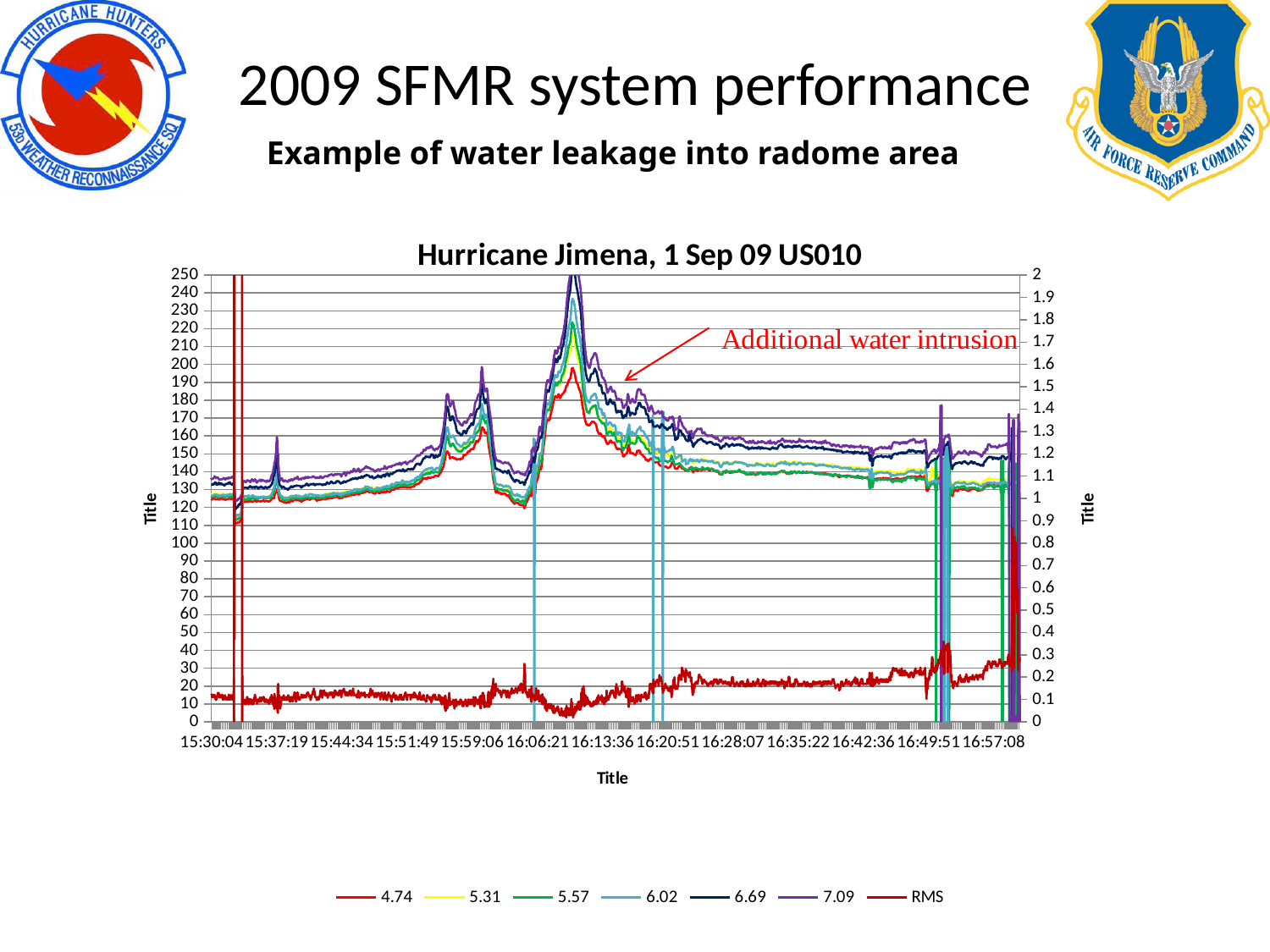
Is the value of the RMS series at 15:30:04 greater or less than 0.5 on the right axis? less At 15:30:04, which series has the higher value, 7.09 or 4.74? 7.09 Does the 4.74 series rise or fall between 16:13:36 and 16:28:07? fall What kind of chart is shown on the slide? line chart Does the 7.09 series rise or fall between 15:30:04 and 15:59:06? rise How many series does the chart legend list? 7 Near 16:13:36, which series reaches the higher peak, 7.09 or 4.74? 7.09 Is the peak value of the 7.09 series near 16:13:36 greater or less than 200 on the left axis? greater Is the value of the 4.74 series at 15:30:04 greater or less than 100 on the left axis? greater What is the title of the chart? Hurricane Jimena, 1 Sep 09 US010 What does the red annotation text on the chart say? Additional water intrusion